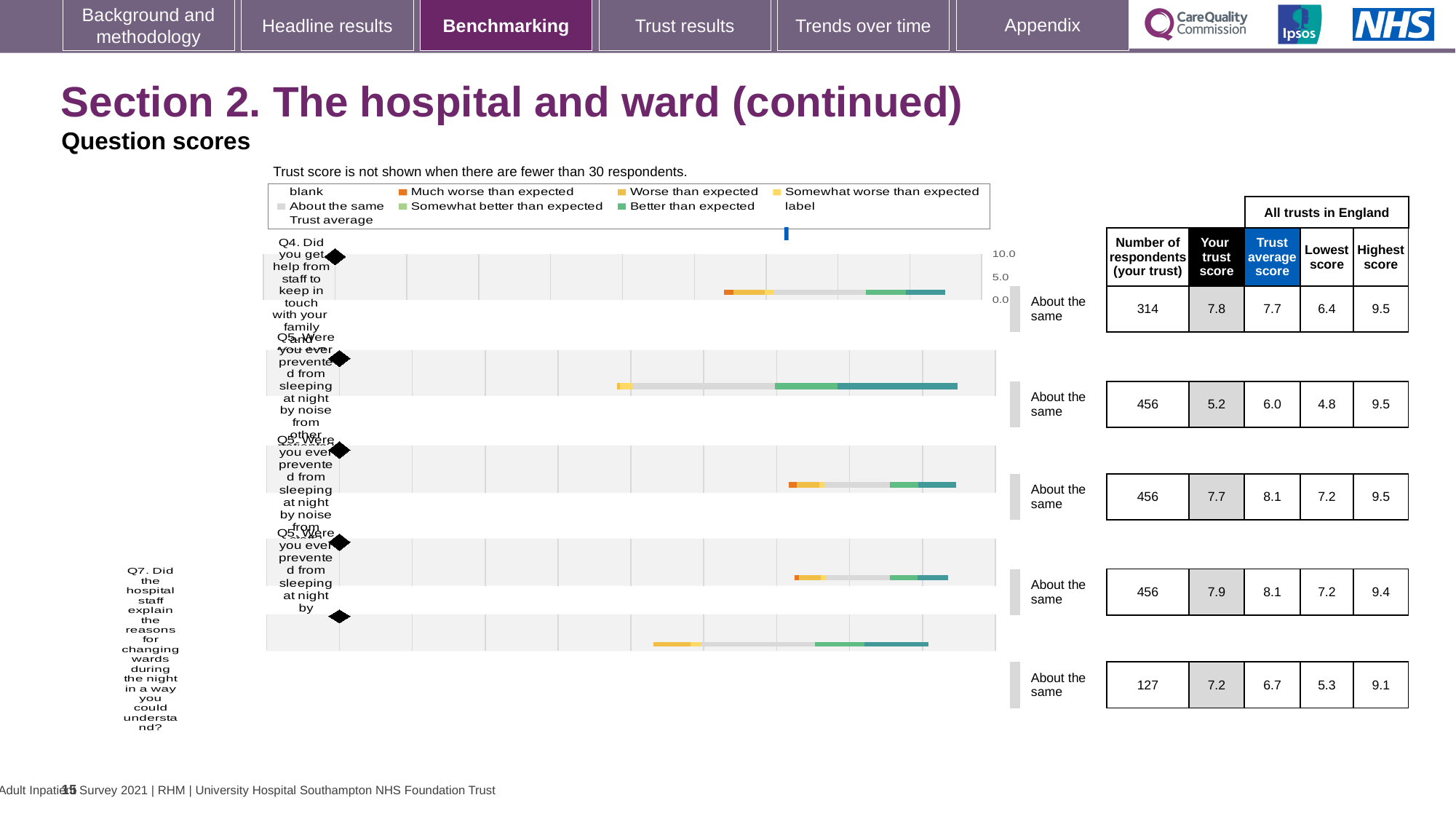
For Q4, what is the difference between the highest score and the lowest score across all trusts in England? 3.1 For Q7, what is the difference between the highest score and the lowest score across all trusts in England? 3.8 What is the 'Your trust score' for Q4 (help from staff to keep in touch with family)? 7.8 How many entries does the legend above the chart list? 9 What is the trust average score for Q4? 7.7 What is the 'Your trust score' for Q7? 7.2 Which question has the lowest number of respondents? Q7 What kind of chart is used to show the question scores on this slide? bar chart For Q7, which is larger: your trust score or the trust average score? your trust score How many respondents are shown for Q7 (explaining reasons for changing wards during the night)? 127 How many question rows (bars) are plotted on the slide? 5 What comparison category is shown next to the Q4 bar? About the same